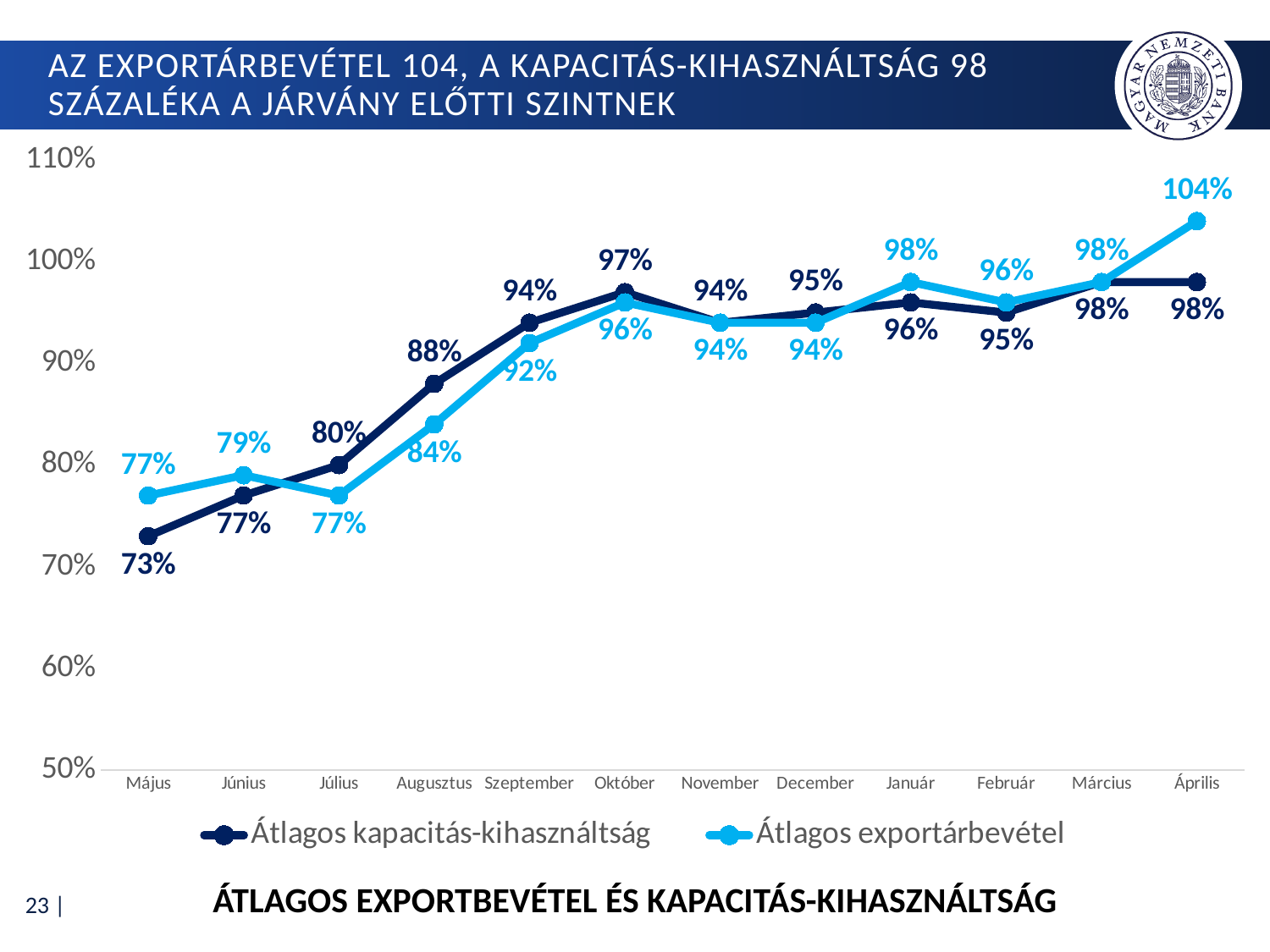
What is the difference between Átlagos kapacitás-kihasználtság and Átlagos exportárbevétel in Augusztus? 4% In which month is Átlagos kapacitás-kihasználtság lowest? Május In Január, which series has the higher value: Átlagos kapacitás-kihasználtság or Átlagos exportárbevétel? Átlagos exportárbevétel What is the value of Átlagos exportárbevétel in Április? 104% What type of chart is shown on the slide? line chart What is the value of Átlagos kapacitás-kihasználtság in Május? 73% How many series does the legend list? 2 Does Átlagos kapacitás-kihasználtság generally rise or fall from Május to Április? rise What is the value of Átlagos kapacitás-kihasználtság in Október? 97% What is the value of Átlagos exportárbevétel in Augusztus? 84% In which month is Átlagos exportárbevétel highest? Április How many months are plotted along the x axis? 12